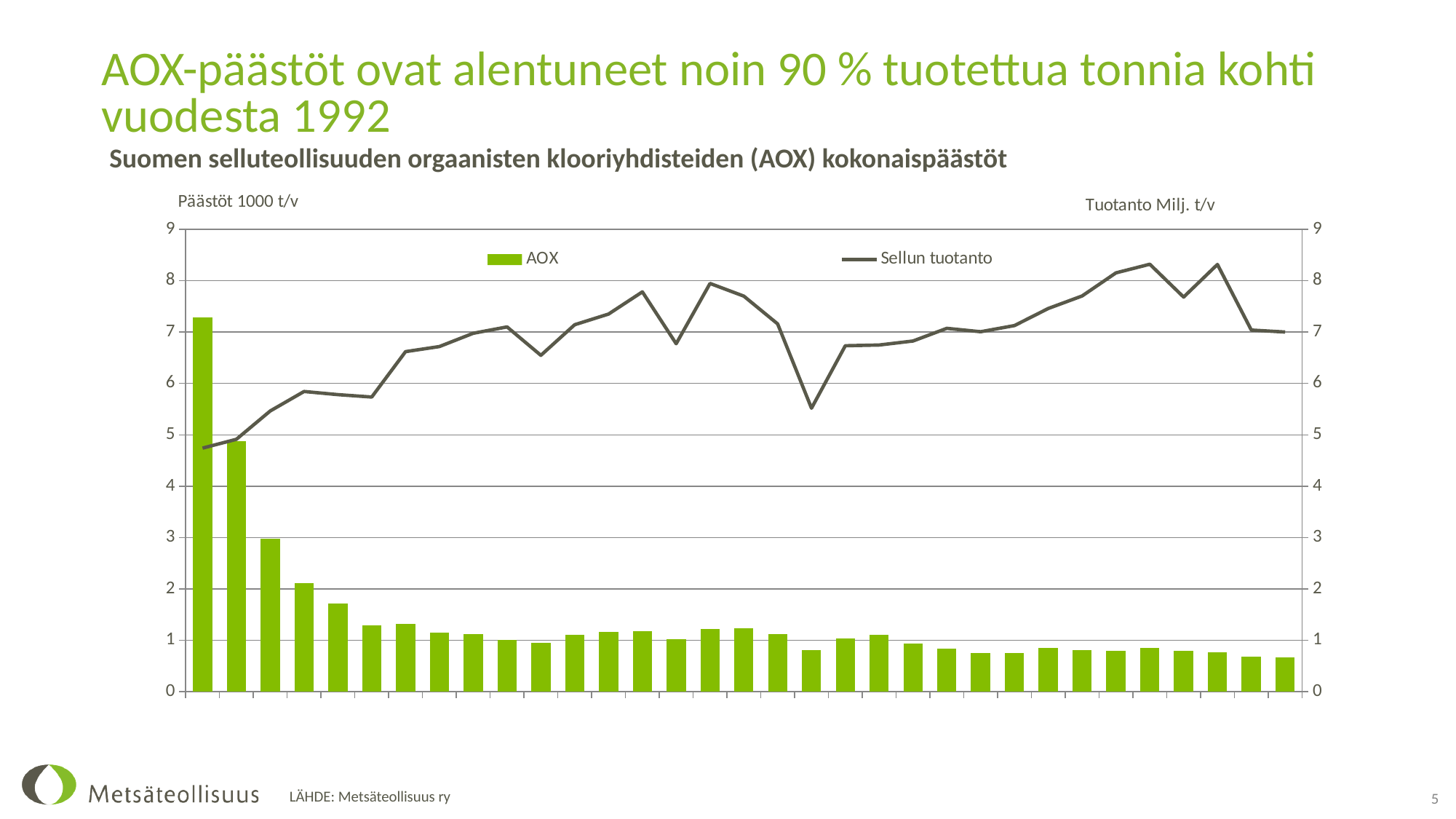
Is the first point of the Sellun tuotanto line greater or less than 5? less How many bars are plotted for the AOX series? 33 Is the value of the leftmost AOX bar greater or less than 7? greater Which AOX bar is the highest? The leftmost (first) bar How many series does the chart legend list? 2 What is the title of the left vertical axis? Päästöt 1000 t/v Do the AOX bar values generally rise or fall from left to right along the x axis? fall What are the two series named in the legend? AOX and Sellun tuotanto Is the value of the third AOX bar from the left greater or less than 2? greater What kind of chart is shown on the slide? A combined bar and line chart Which is larger: the leftmost AOX bar or the second AOX bar from the left? The leftmost AOX bar